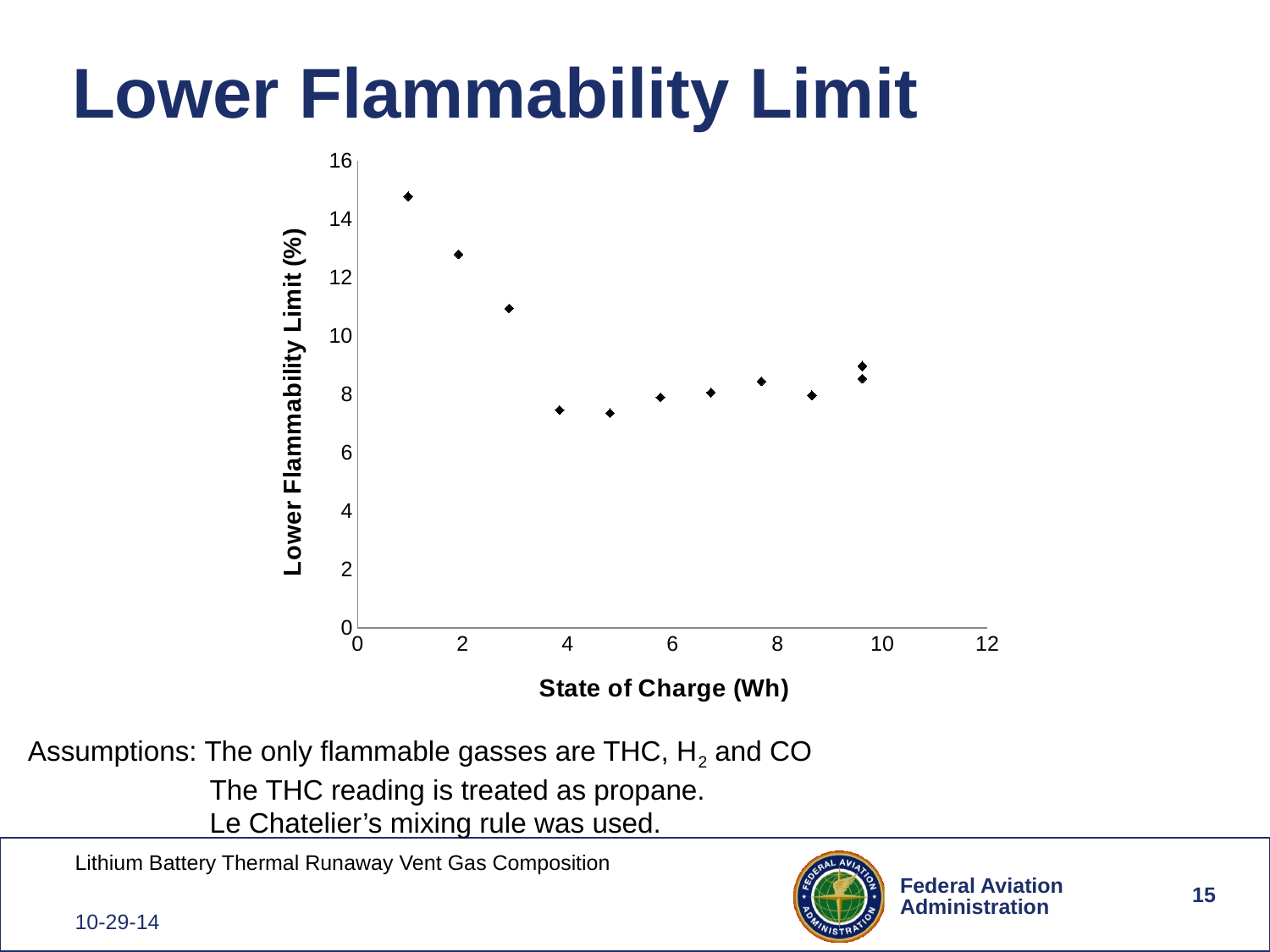
What is the title of the chart's x axis? State of Charge (Wh) Which point has the larger lower flammability limit: the one at about 2 Wh or the one at about 6 Wh? the one at about 2 Wh Is the lower flammability limit for the point at about 8 Wh greater or less than 8? greater Is the lower flammability limit for the point at about 3 Wh greater or less than 10? greater Between about 1 Wh and 4 Wh of state of charge, do the lower flammability limit values rise or fall? fall What is the title of the chart's y axis? Lower Flammability Limit (%) Does the highest lower flammability limit occur at the lowest or the highest state of charge plotted? lowest Is the lower flammability limit for the point at about 2 Wh greater or less than 12? greater What kind of chart is shown on the slide? scatter chart